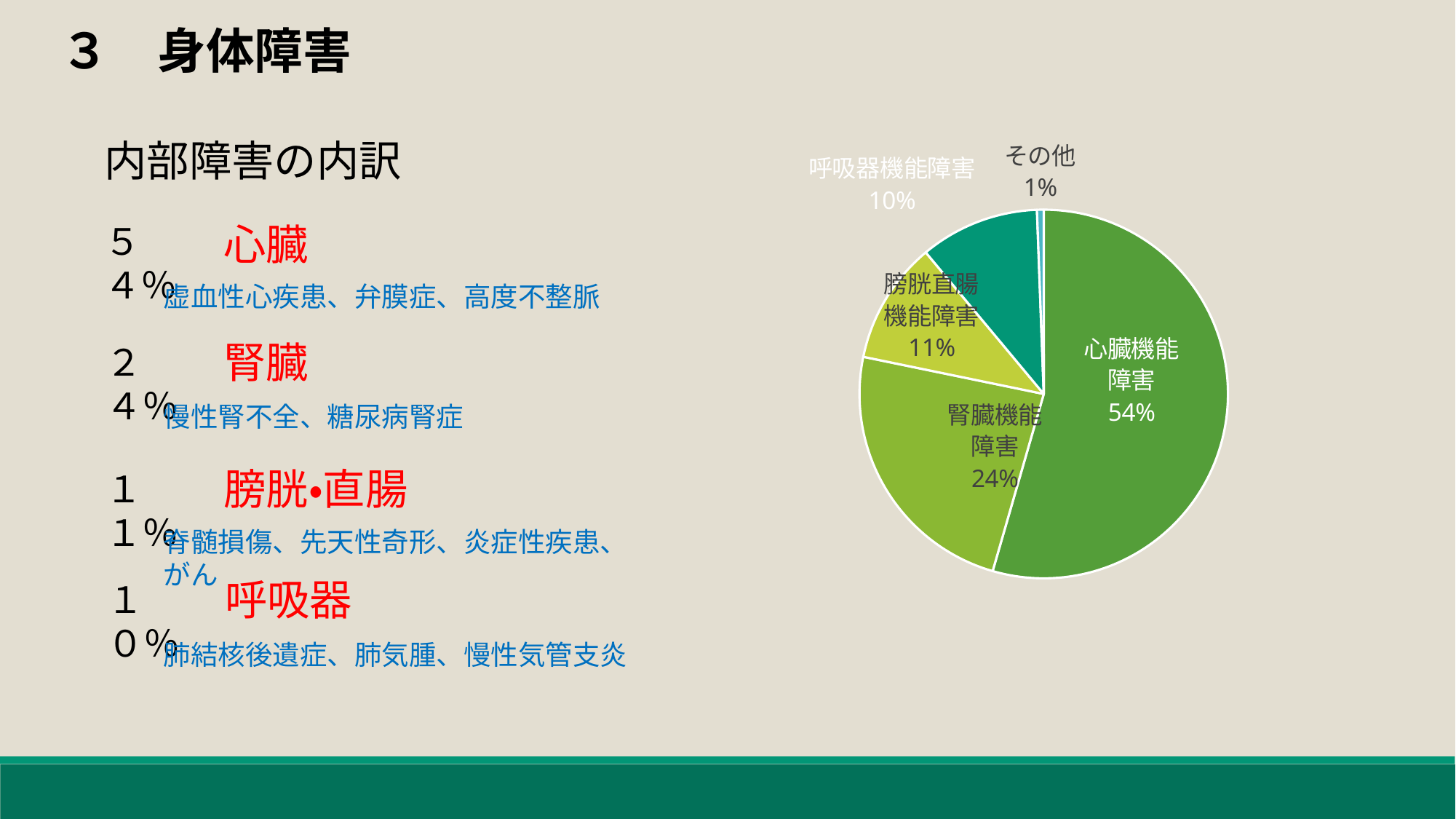
What is the difference in percentage points between 心臓機能障害 and 腎臓機能障害? 30 Which is larger, the slice for 腎臓機能障害 or the slice for 呼吸器機能障害? 腎臓機能障害 What share of the pie does その他 have? 1% Which category has the largest slice of the pie? 心臓機能障害 Which category has the smallest slice of the pie? その他 How many slices does the pie chart have? 5 What share of the pie does 心臓機能障害 have? 54% What share of the pie does 腎臓機能障害 have? 24% What is the combined share of 膀胱直腸機能障害 and 呼吸器機能障害? 21% What kind of chart is shown on the slide? pie chart